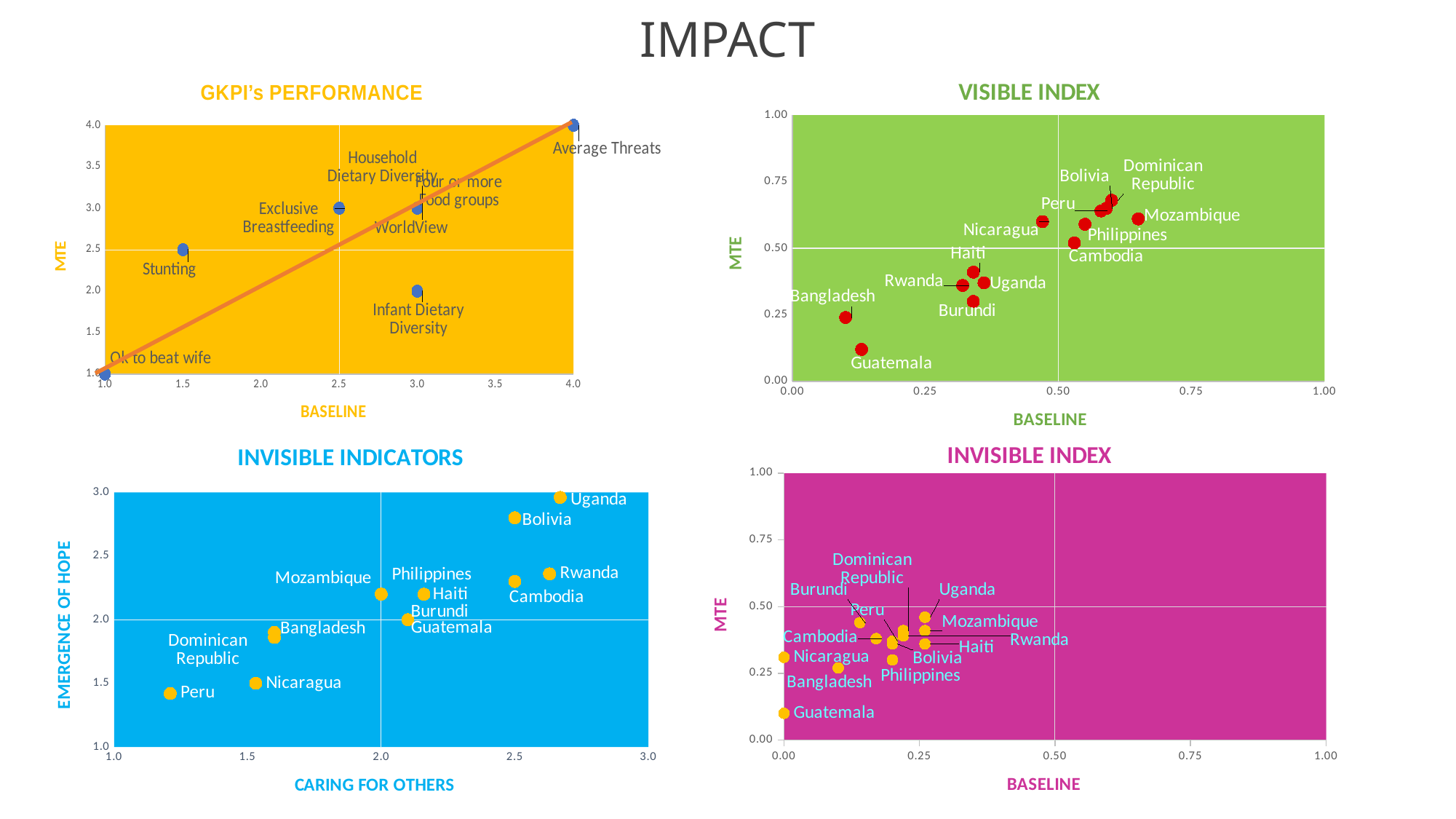
In the VISIBLE INDEX chart, is the BASELINE value for Mozambique greater or less than 0.50? greater In the INVISIBLE INDICATORS chart, is the CARING FOR OTHERS value for Peru greater or less than 1.5? less In the INVISIBLE INDEX chart, is the MTE value for Guatemala greater or less than 0.25? less In the INVISIBLE INDICATORS chart, which country has the highest EMERGENCE OF HOPE value? Uganda What kind of chart is the VISIBLE INDEX chart? scatter chart What is the x-axis title of the INVISIBLE INDICATORS chart? CARING FOR OTHERS In the GKPI's PERFORMANCE chart, what is the MTE value for Average Threats? 4.0 In the VISIBLE INDEX chart, which has the higher MTE value, Bangladesh or Peru? Peru In the GKPI's PERFORMANCE chart, which indicator has the highest MTE value? Average Threats In the VISIBLE INDEX chart, which country has the lowest MTE value? Guatemala In the GKPI's PERFORMANCE chart, what is the BASELINE value for Ok to beat wife? 1.0 In the INVISIBLE INDEX chart, which country has the lowest MTE value? Guatemala